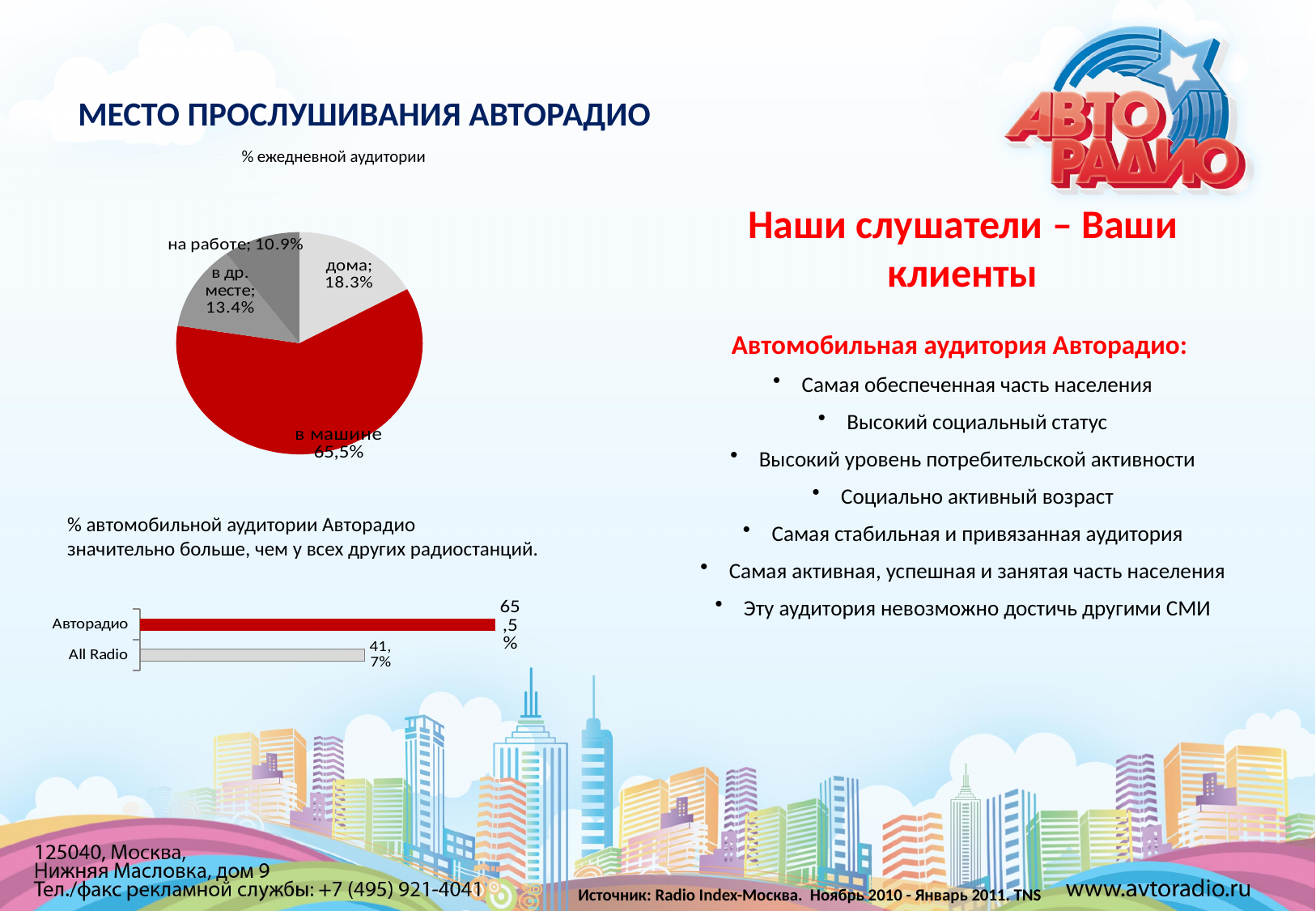
In the pie chart, which listening place has the largest share? в машине In the bar chart at the bottom left, what is the value for All Radio? 41,7% In the pie chart, which listening place has the smallest share? на работе In the bar chart at the bottom left, what is the difference between the Авторадио value and the All Radio value? 23,8% What type of chart is the one at the bottom left comparing Авторадио and All Radio? bar chart In the pie chart, what is the value for на работе (at work)? 10.9% In the bar chart at the bottom left, what is the value for Авторадио? 65,5% In the pie chart, which is larger: the share for дома or the share for в др. месте? дома In the pie chart, what is the value for в др. месте (in another place)? 13.4% In the pie chart, what share of the daily audience listens to Avtoradio in the car (в машине)? 65,5% In the pie chart, how many slices (listening places) are shown? 4 In the pie chart, what is the value for дома (at home)? 18.3%